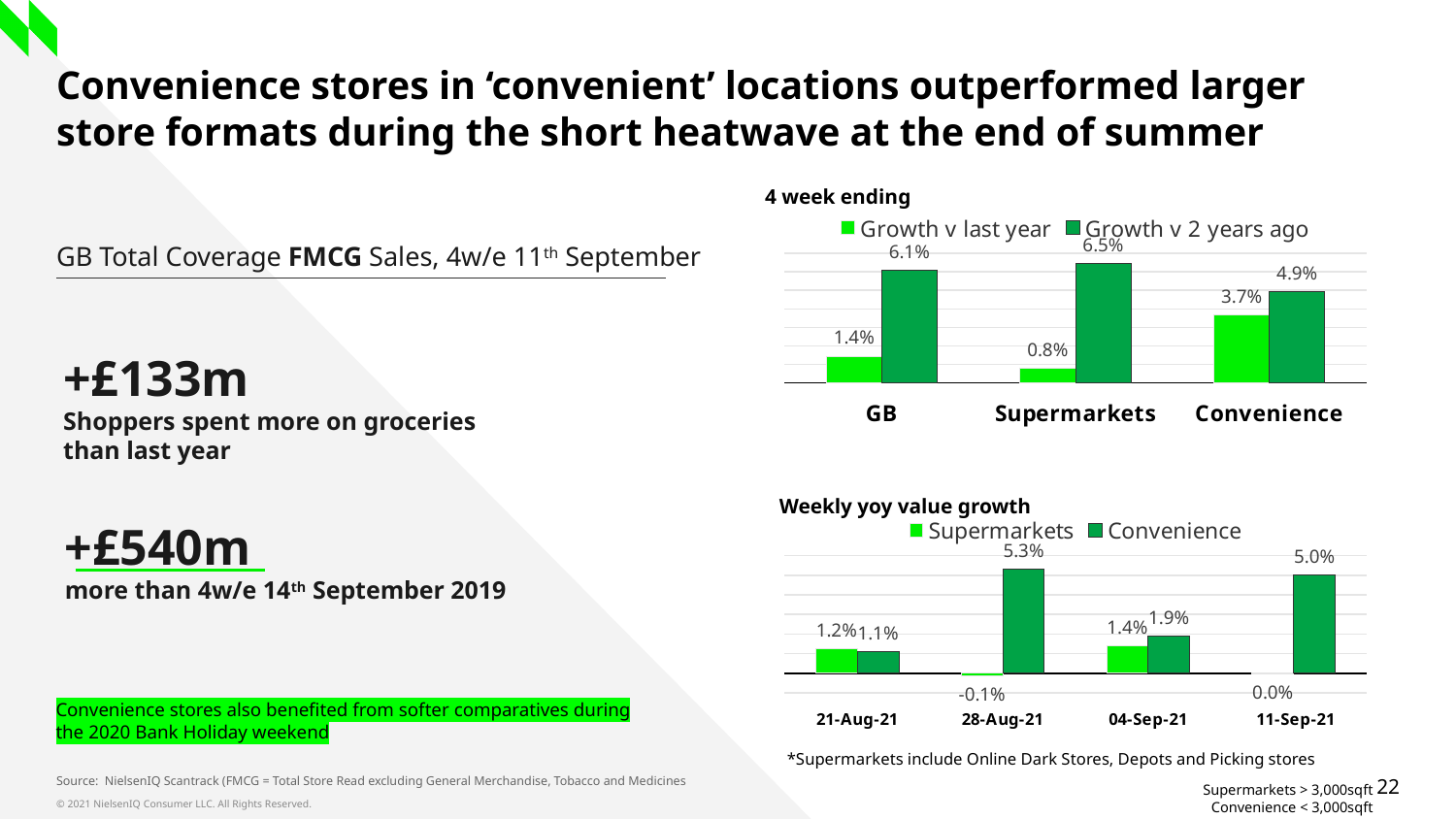
In the '4 week ending' chart, which category has the highest Growth v last year? Convenience In the 'Weekly yoy value growth' chart, which week has the lowest Supermarkets value? 28-Aug-21 In the 'Weekly yoy value growth' chart, what is the Supermarkets value for 11-Sep-21? 0.0% What type of chart is the 'Weekly yoy value growth' chart? Bar chart How many weeks are shown on the x axis of the 'Weekly yoy value growth' chart? 4 In the 'Weekly yoy value growth' chart, which is larger for 21-Aug-21: Supermarkets or Convenience? Supermarkets In the 'Weekly yoy value growth' chart, what is the Convenience value for 28-Aug-21? 5.3% How many series does the legend of the '4 week ending' chart list? 2 In the '4 week ending' chart, what is the Growth v 2 years ago value for Supermarkets? 6.5% In the '4 week ending' chart, what is the difference between Growth v 2 years ago and Growth v last year for GB? 4.7% In the '4 week ending' chart, what is the Growth v last year value for Convenience? 3.7% In the '4 week ending' chart, which category has the lowest Growth v 2 years ago? Convenience